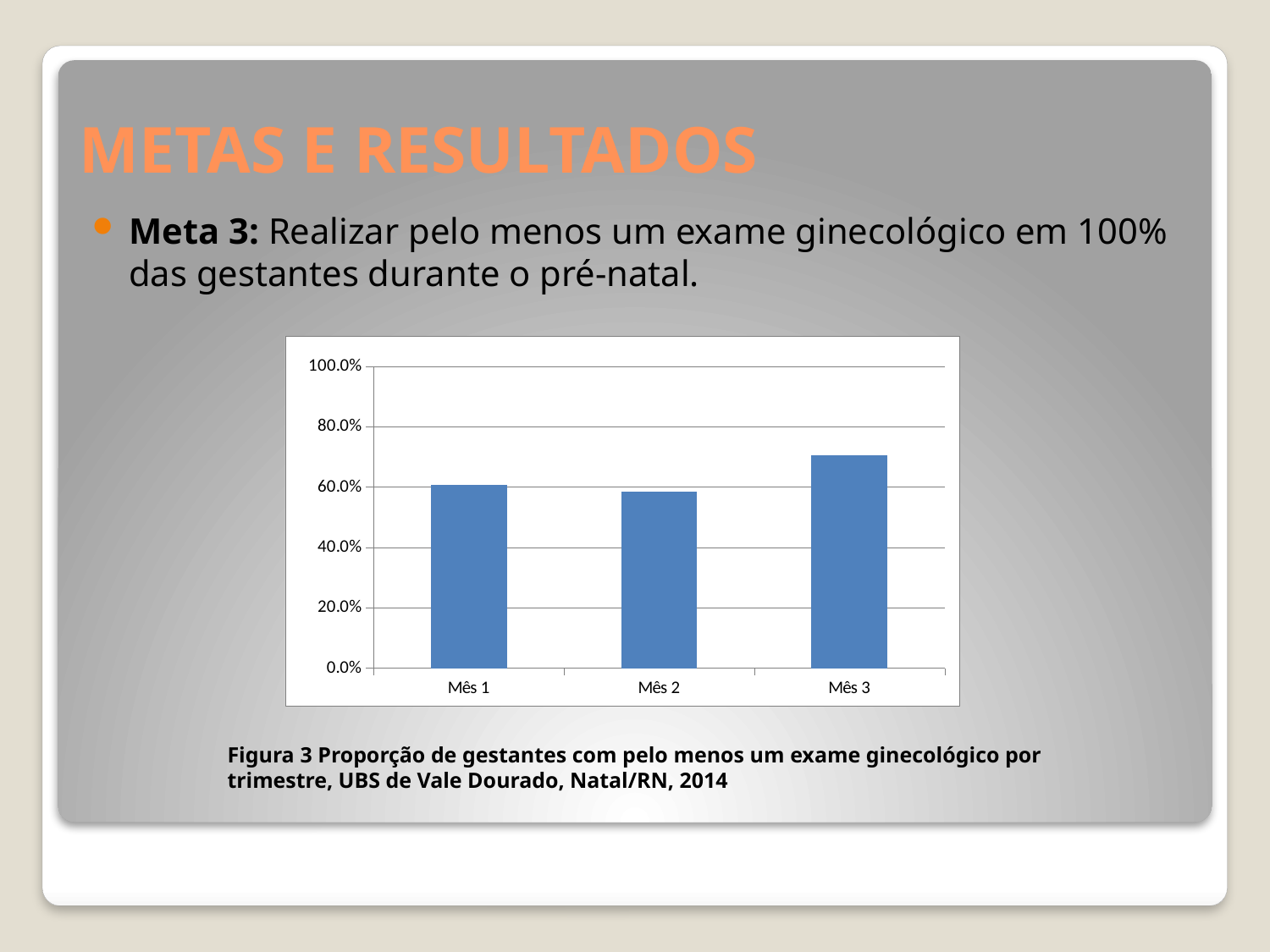
Which is larger, the value for Mês 3 or the value for Mês 2? Mês 3 Is the value for Mês 1 greater or less than 40.0%? greater Is the value for Mês 3 greater or less than 80.0%? less Which month has the highest value on the chart? Mês 3 Is the value for Mês 2 greater or less than 80.0%? less Does the value rise or fall from Mês 2 to Mês 3? rise What kind of chart is shown on the slide? bar chart What is the highest value shown on the vertical axis of the chart? 100.0% How many categories (months) are plotted on the chart? 3 Which is larger, the value for Mês 3 or the value for Mês 1? Mês 3